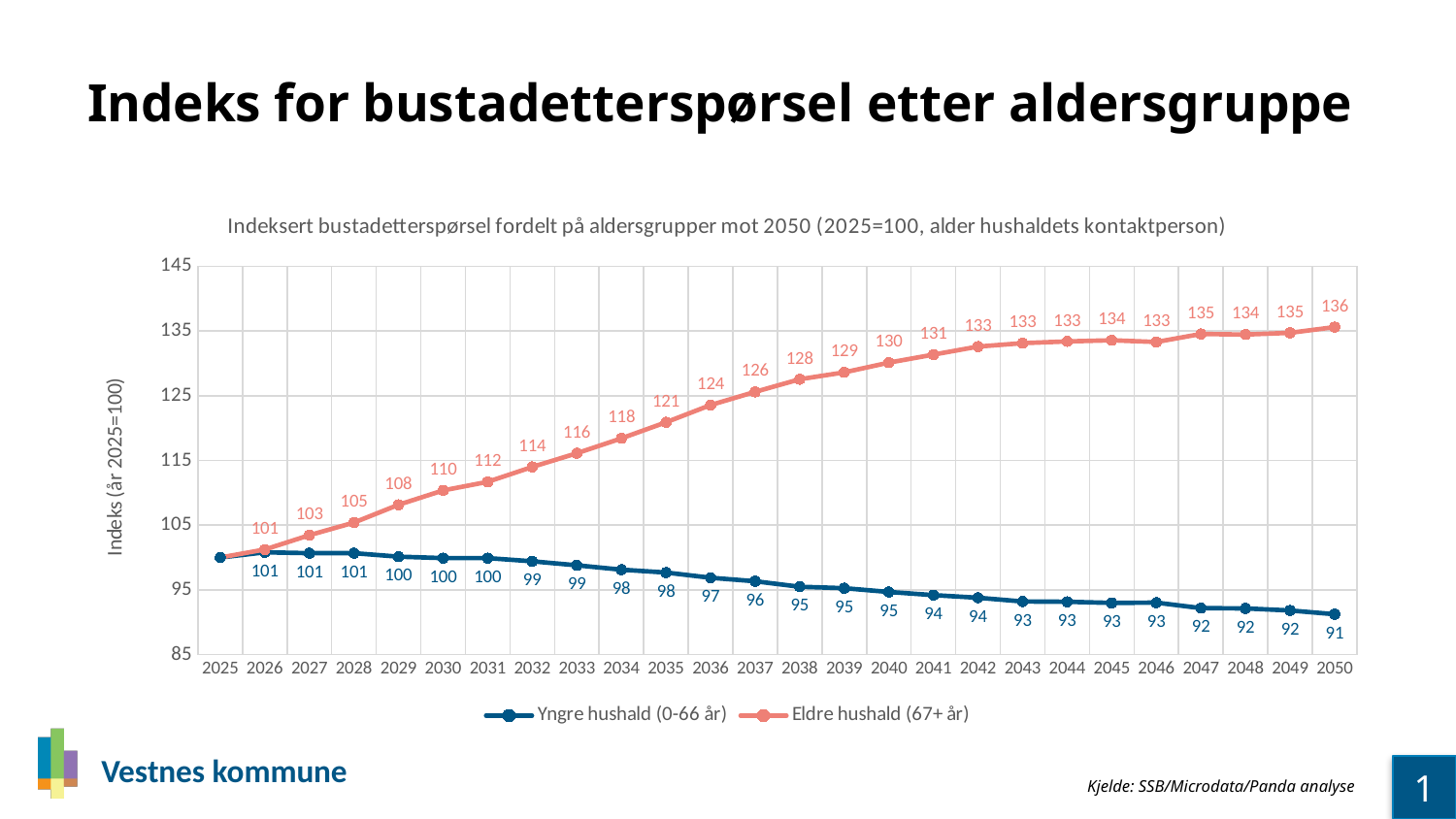
What is the difference between the Eldre hushald (67+ år) and Yngre hushald (0-66 år) values in 2050? 45 Does the Eldre hushald (67+ år) series rise or fall from 2025 to 2050? rise What kind of chart is shown on the slide? line chart Does the Yngre hushald (0-66 år) series rise or fall from 2025 to 2050? fall What is the value for Yngre hushald (0-66 år) in 2050? 91 Which series has the higher value in 2040, Yngre hushald (0-66 år) or Eldre hushald (67+ år)? Eldre hushald (67+ år) In which year does Yngre hushald (0-66 år) reach its lowest value? 2050 In which year does Eldre hushald (67+ år) reach its highest value? 2050 What is the value for Eldre hushald (67+ år) in 2050? 136 What is the value for Eldre hushald (67+ år) in 2035? 121 What is the value for Yngre hushald (0-66 år) in 2040? 95 How many series does the legend list? 2